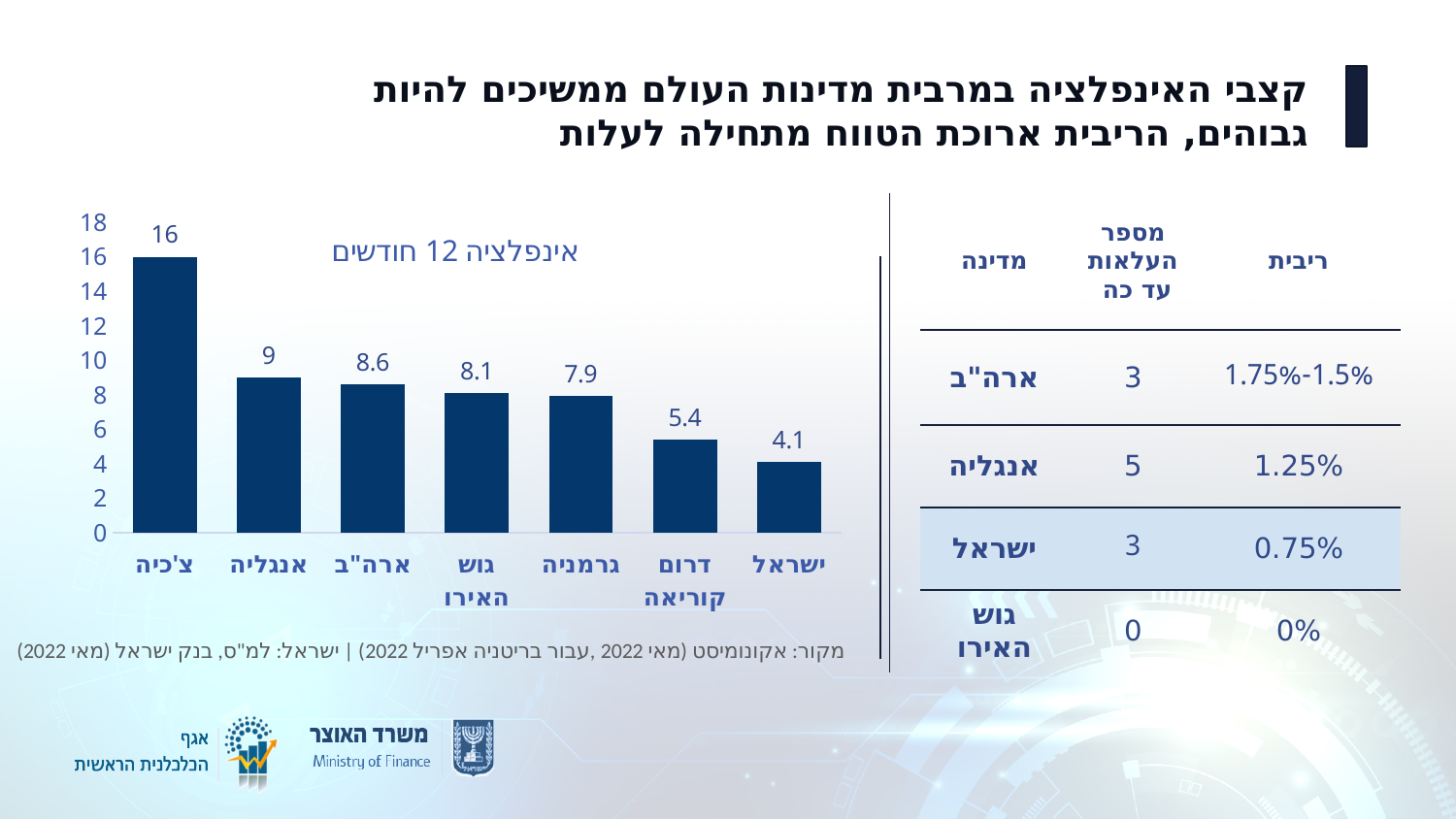
Which has a higher 12-month inflation value, גרמניה or דרום קוריאה? גרמניה What is the difference between the inflation values for אנגליה and ארה"ב? 0.4 What is the difference between the inflation values for צ'כיה and ישראל? 11.9 Which country has the highest 12-month inflation in the chart? צ'כיה What is the title of the chart? אינפלציה 12 חודשים What is the 12-month inflation value shown for צ'כיה? 16 What is the 12-month inflation value shown for דרום קוריאה? 5.4 What is the 12-month inflation value shown for גוש האירו? 8.1 What type of chart is used to show 12-month inflation? Bar chart How many countries or regions are shown in the bar chart? 7 Which country has the lowest 12-month inflation in the chart? ישראל What is the 12-month inflation value shown for ישראל? 4.1